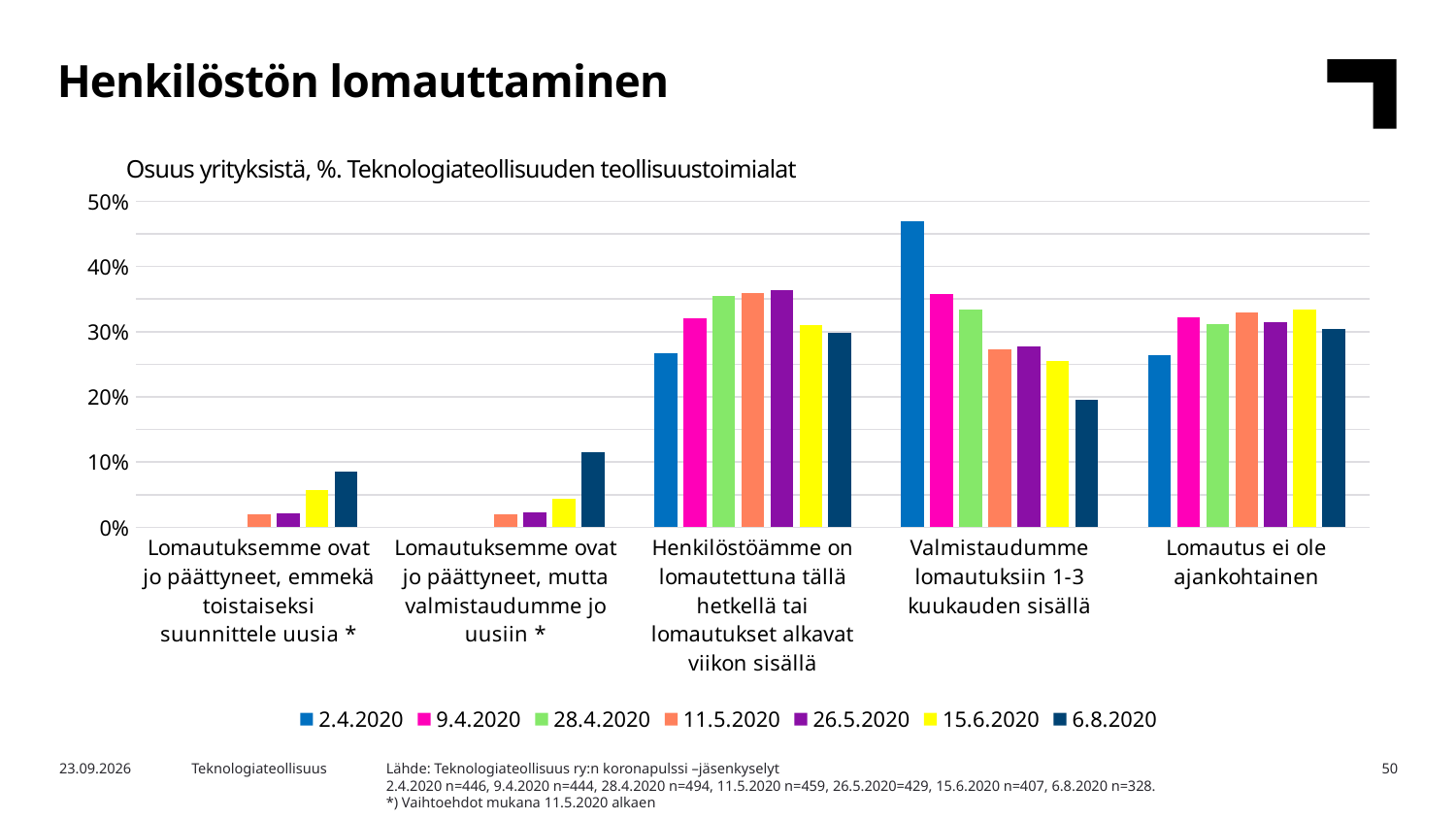
Is the 6.8.2020 value for 'Lomautuksemme ovat jo päättyneet, emmekä toistaiseksi suunnittele uusia *' greater or less than 10%? less Within 'Valmistaudumme lomautuksiin 1-3 kuukauden sisällä', which survey date has the lowest value? 6.8.2020 How many series does the legend list? 7 For 'Henkilöstöämme on lomautettuna tällä hetkellä tai lomautukset alkavat viikon sisällä', which is larger: the 2.4.2020 value or the 26.5.2020 value? 26.5.2020 Which category contains the tallest bar in the chart? Valmistaudumme lomautuksiin 1-3 kuukauden sisällä For 2.4.2020, which is larger: 'Valmistaudumme lomautuksiin 1-3 kuukauden sisällä' or 'Henkilöstöämme on lomautettuna tällä hetkellä tai lomautukset alkavat viikon sisällä'? Valmistaudumme lomautuksiin 1-3 kuukauden sisällä Is the 2.4.2020 value for 'Valmistaudumme lomautuksiin 1-3 kuukauden sisällä' greater or less than 40%? greater How many categories are shown on the x axis? 5 Is the 6.8.2020 value for 'Lomautuksemme ovat jo päättyneet, mutta valmistaudumme jo uusiin *' greater or less than 10%? greater What is the title of the slide? Henkilöstön lomauttaminen For 'Valmistaudumme lomautuksiin 1-3 kuukauden sisällä', do the values rise or fall from 2.4.2020 to 6.8.2020? fall What kind of chart is shown on the slide? Bar chart